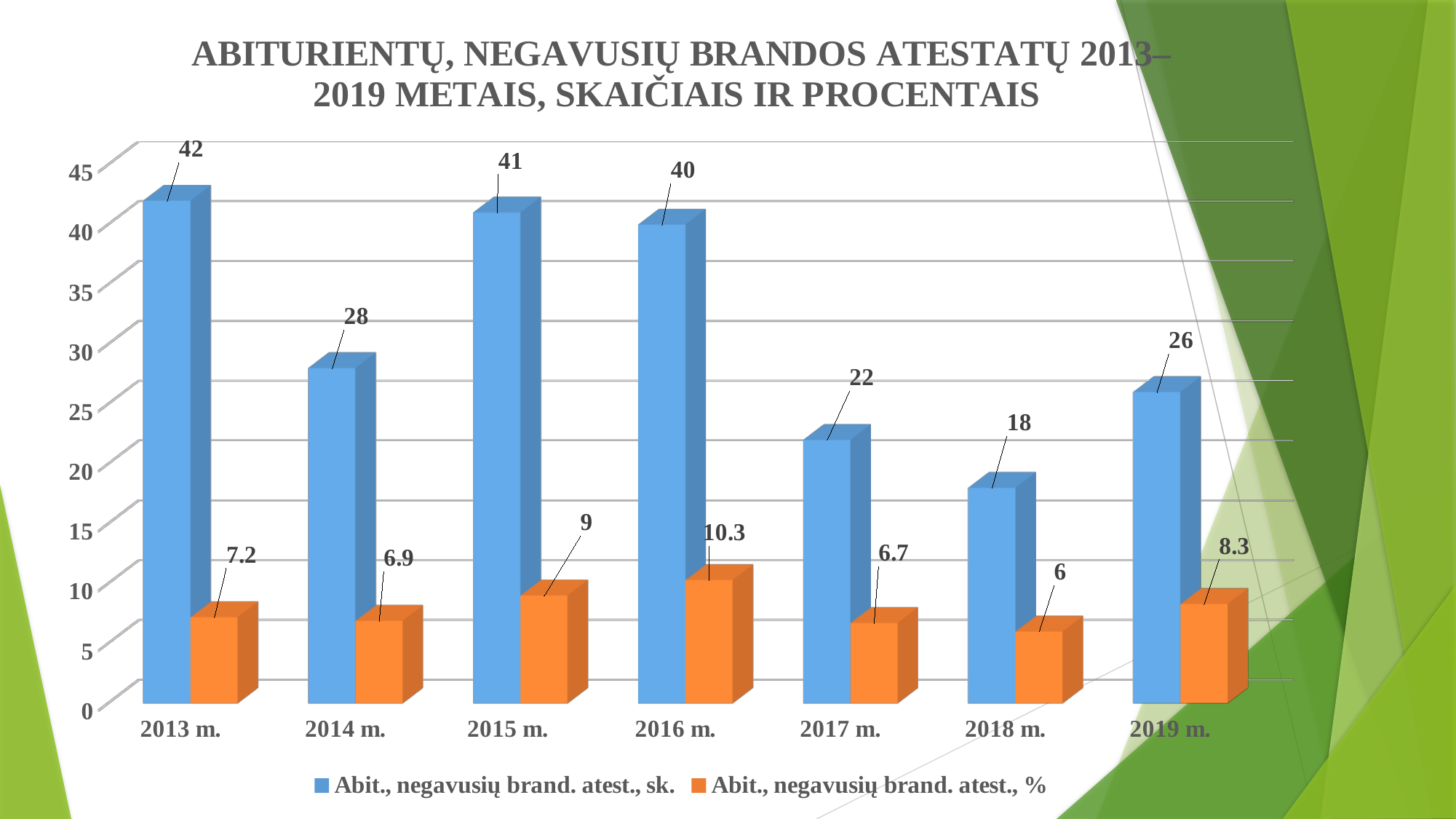
Is the value of 'Abit., negavusių brand. atest., sk.' for 2017 m. greater or less than 25? less Which year has the highest value for 'Abit., negavusių brand. atest., sk.'? 2013 m. What is the value of 'Abit., negavusių brand. atest., sk.' for 2013 m.? 42 What is the value of 'Abit., negavusių brand. atest., %' for 2016 m.? 10.3 How many years are shown on the x axis? 7 Which year has the lowest value for 'Abit., negavusių brand. atest., %'? 2018 m. Which colour represents 'Abit., negavusių brand. atest., %' in the chart? orange What kind of chart is shown on the slide? bar chart How many series does the legend list? 2 Which is larger: the 'Abit., negavusių brand. atest., %' value for 2015 m. or for 2019 m.? 2015 m. What is the value of 'Abit., negavusių brand. atest., sk.' for 2018 m.? 18 What is the difference between the 'Abit., negavusių brand. atest., sk.' values for 2013 m. and 2014 m.? 14